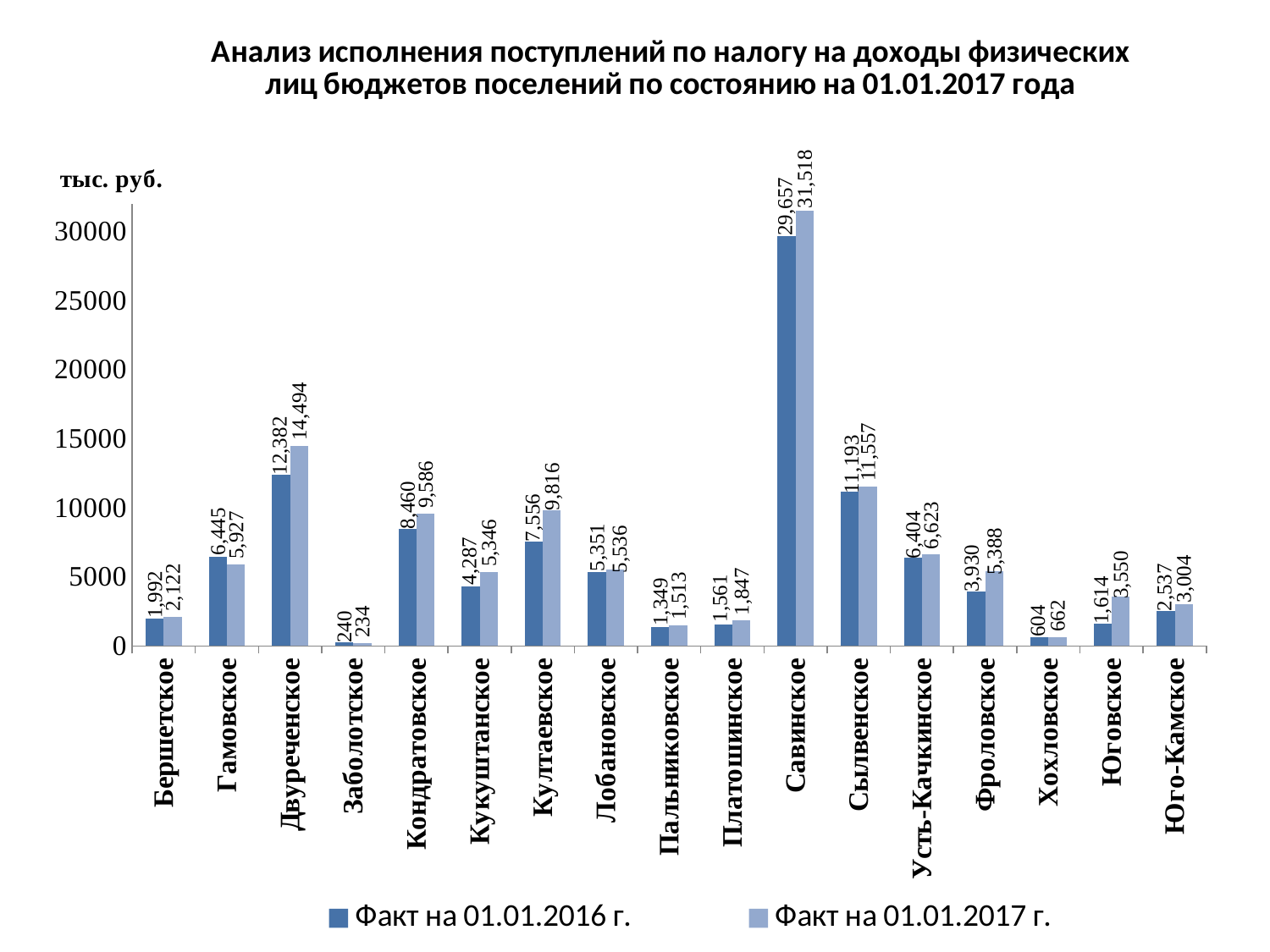
Which category has the lowest value in the series Факт на 01.01.2017 г.? Заболотское How many series does the legend list? 2 For Гамовское, which is larger: the value for Факт на 01.01.2016 г. or Факт на 01.01.2017 г.? Факт на 01.01.2016 г. Which category has the highest value in the series Факт на 01.01.2016 г.? Савинское What is the value for Фроловское in the series Факт на 01.01.2017 г.? 5,388 What is the difference between the Факт на 01.01.2017 г. and Факт на 01.01.2016 г. values for Юговское? 1,936 How many categories are shown on the x axis? 17 Is the value for Сылвенское in the series Факт на 01.01.2017 г. greater or less than 10000? greater What is the value for Савинское in the series Факт на 01.01.2017 г.? 31,518 What is the value for Двуреченское in the series Факт на 01.01.2016 г.? 12,382 What is the difference between the Факт на 01.01.2017 г. and Факт на 01.01.2016 г. values for Савинское? 1,861 What kind of chart is shown on the slide? bar chart